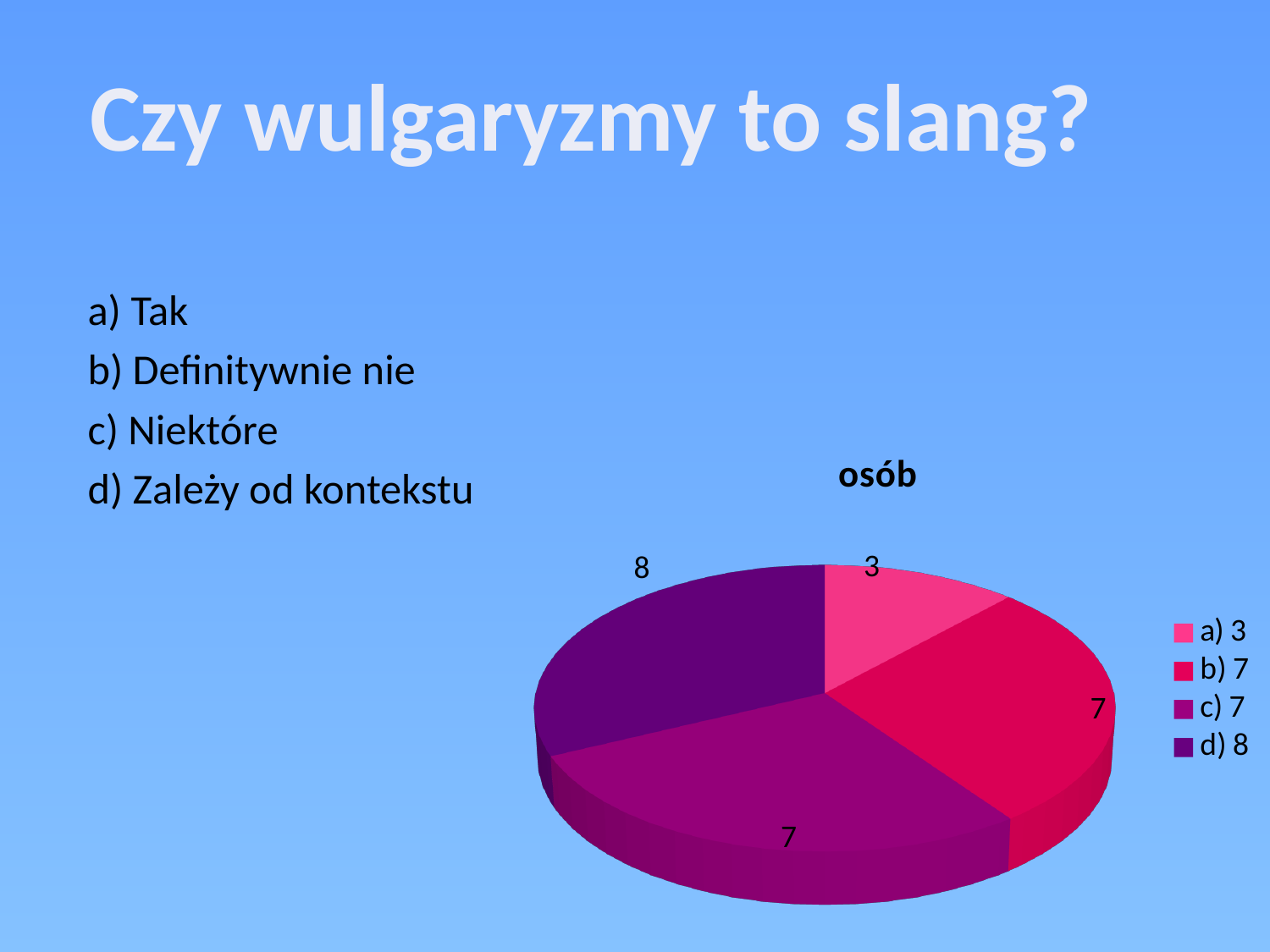
Which slice of the pie chart has the smallest value? a) What is the value for slice a) in the pie chart? 3 What is the title of the chart? osób What is the value for slice d) in the pie chart? 8 What share of the pie does slice d) represent? 32% Which slice of the pie chart has the largest value? d) What is the difference between the values for slice d) and slice a)? 5 What is the total of all slice values in the pie chart? 25 How many slices does the pie chart have? 4 Which is larger, the value for slice a) or the value for slice c)? c) What kind of chart is shown on the slide? pie chart What is the value for slice b) in the pie chart? 7